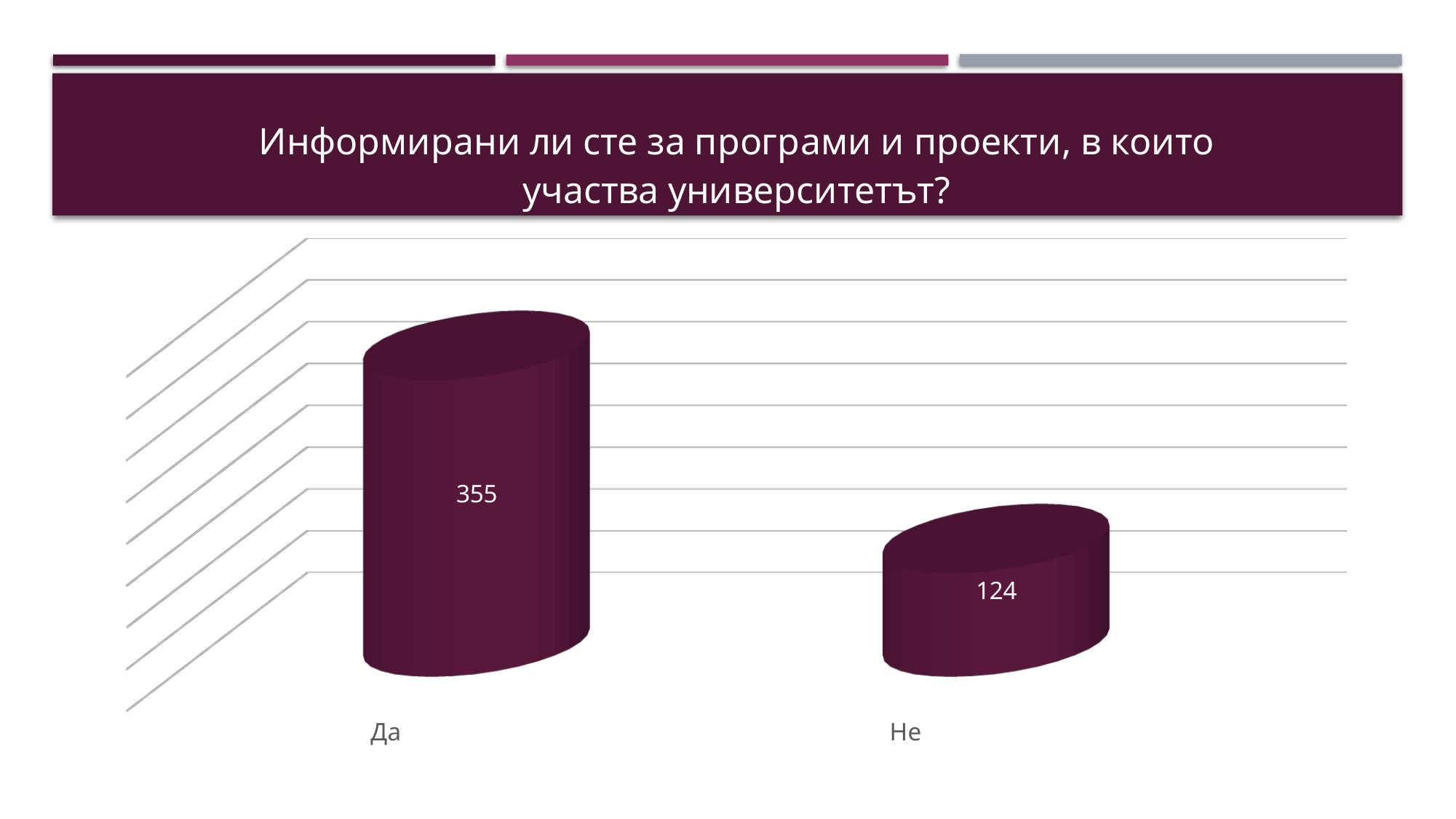
Which category has the lowest value? Не How many categories are shown in the chart? 2 Which is larger, the value for "Да" or the value for "Не"? Да What is the total of the values for "Да" and "Не"? 479 What is the value for "Да"? 355 What is the title of the slide above the chart? Информирани ли сте за програми и проекти, в които участва университетът? Which category has the highest value? Да What colour are the bars in the chart? dark purple What is the value for "Не"? 124 What is the difference between the values for "Да" and "Не"? 231 What kind of chart is shown on the slide? bar chart